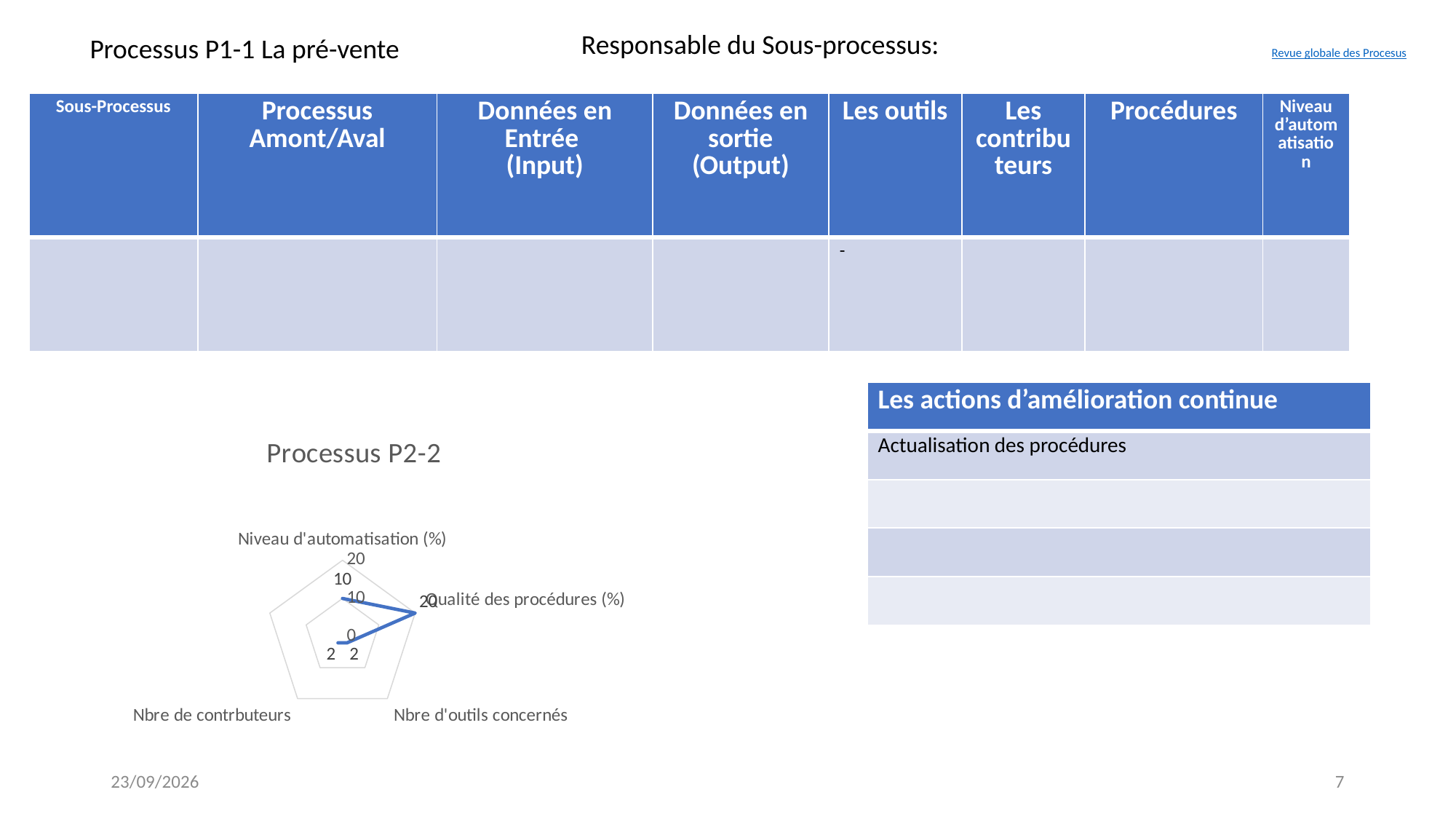
What kind of chart is shown on the slide? radar chart What is the maximum value shown on the chart's axis scale? 20 Is the value for Nbre de contributeurs greater or less than 10? less What is the title of the chart? Processus P2-2 What is the value for Niveau d'automatisation (%) in the chart? 10 Which category has the highest value in the chart? Qualité des procédures (%) Is the value for Nbre d'outils concernés greater or less than 10? less Which is larger, the value for Qualité des procédures (%) or the value for Niveau d'automatisation (%)? Qualité des procédures (%) What is the difference between the value for Qualité des procédures (%) and the value for Niveau d'automatisation (%)? 10 What is the value for Qualité des procédures (%) in the chart? 20